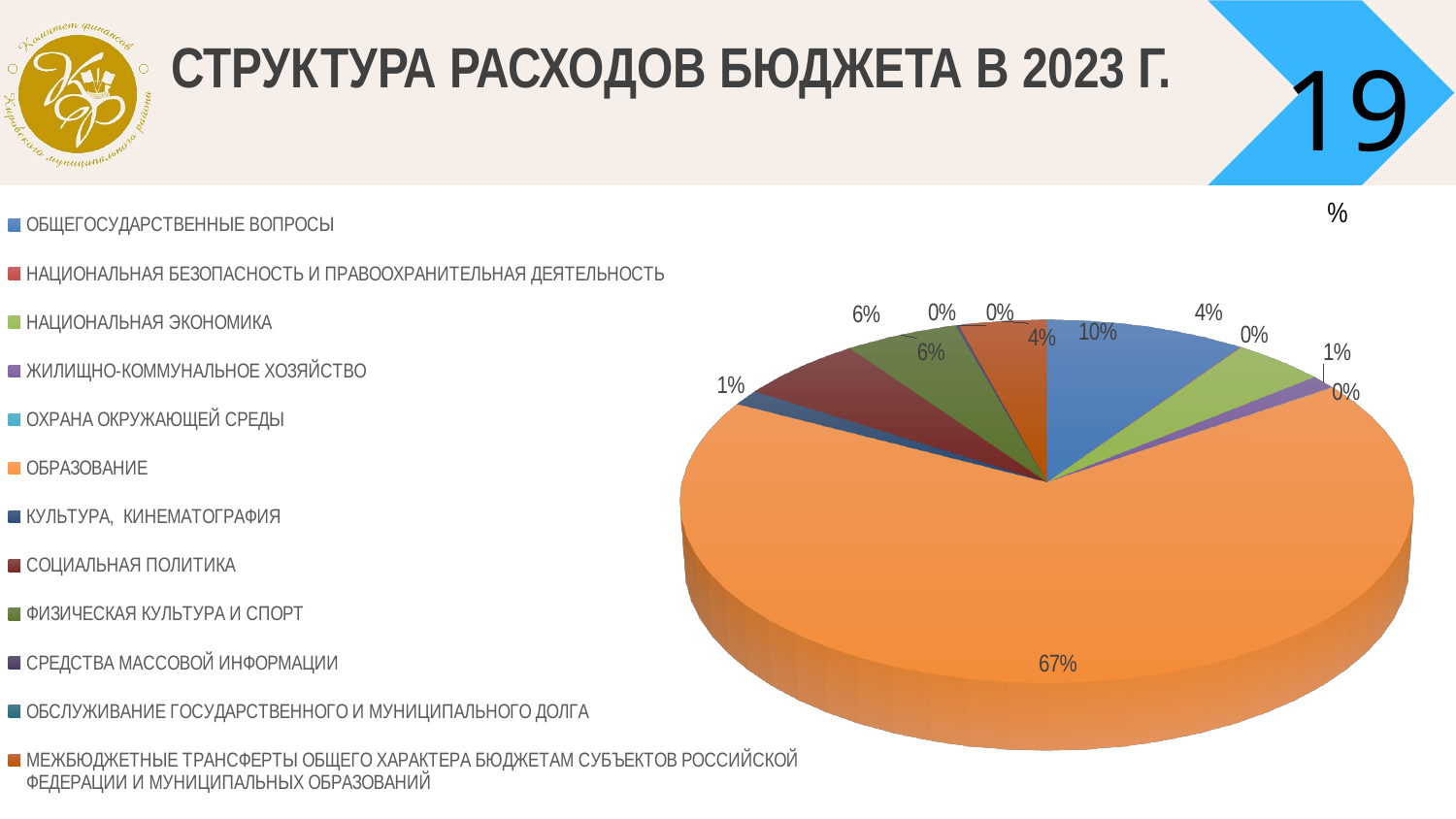
What is the value for СОЦИАЛЬНАЯ ПОЛИТИКА? 6% What is the value for ФИЗИЧЕСКАЯ КУЛЬТУРА И СПОРТ? 6% What is the value for НАЦИОНАЛЬНАЯ ЭКОНОМИКА? 4% How many categories does the legend list? 12 What is the title of the chart? СТРУКТУРА РАСХОДОВ БЮДЖЕТА В 2023 Г. What is the value for ОБЩЕГОСУДАРСТВЕННЫЕ ВОПРОСЫ? 10% Which is larger, the share for ОБРАЗОВАНИЕ or the share for ОБЩЕГОСУДАРСТВЕННЫЕ ВОПРОСЫ? ОБРАЗОВАНИЕ What share of the pie is ОБРАЗОВАНИЕ? 67% What colour is the slice for ОБРАЗОВАНИЕ? orange Which category has the largest share of the pie? ОБРАЗОВАНИЕ What kind of chart is shown on the slide? pie chart What is the difference in percentage points between ОБРАЗОВАНИЕ and ОБЩЕГОСУДАРСТВЕННЫЕ ВОПРОСЫ? 57